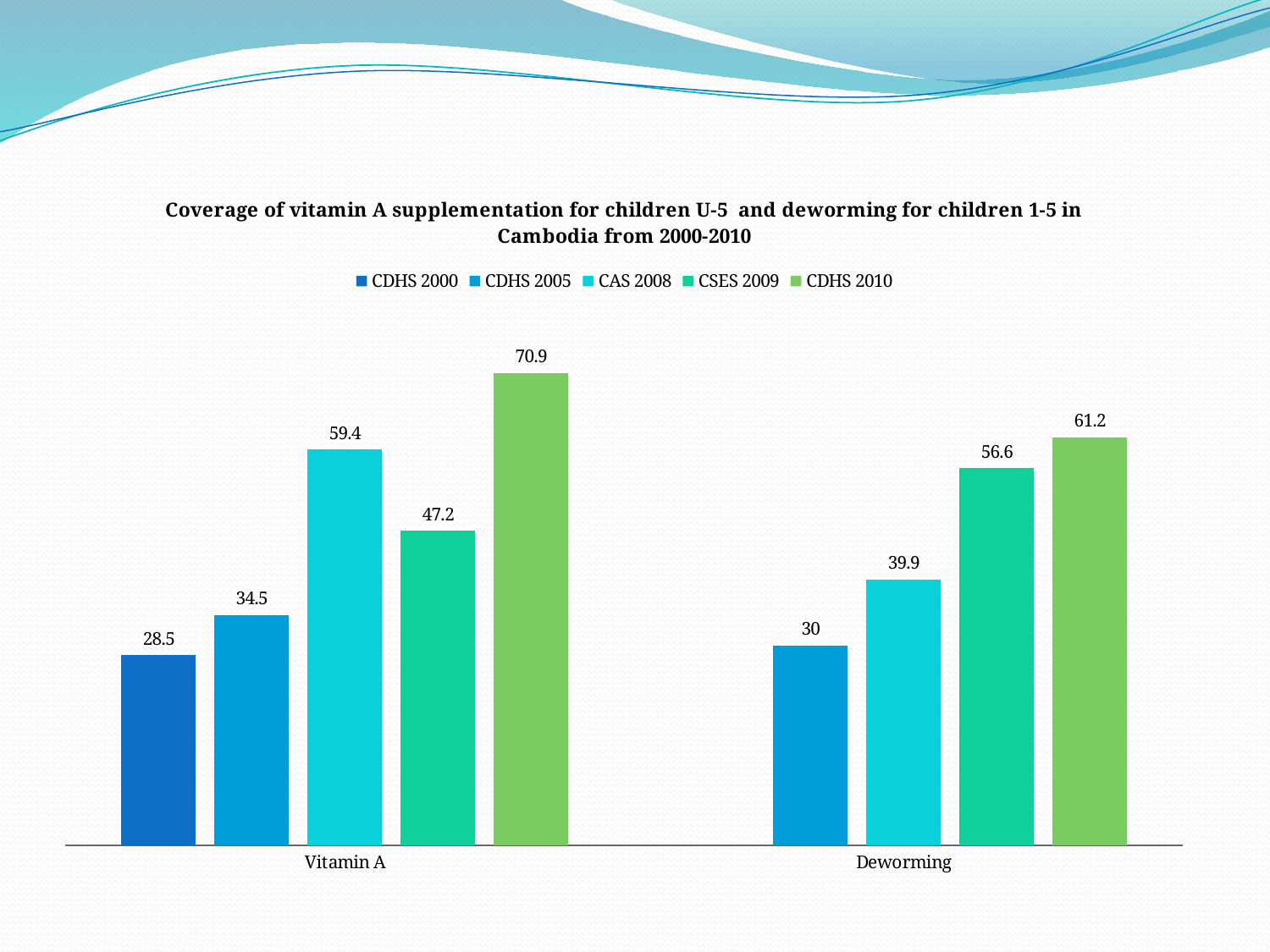
How many series does the legend list? 5 Which series is shown in the lightest green colour in the legend? CDHS 2010 What is the Vitamin A coverage value for CDHS 2000? 28.5 What is the difference between the CDHS 2010 and CSES 2009 values for Deworming? 4.6 Which is larger: the CAS 2008 value for Vitamin A or the CAS 2008 value for Deworming? Vitamin A Which series has the lowest value for Deworming? CDHS 2005 Which series has the highest value for Vitamin A? CDHS 2010 What is the Vitamin A coverage value for CAS 2008? 59.4 How many categories are shown on the x axis? 2 What is the Deworming coverage value for CSES 2009? 56.6 What kind of chart is shown on the slide? Bar chart What is the difference between the CDHS 2010 and CDHS 2000 values for Vitamin A? 42.4